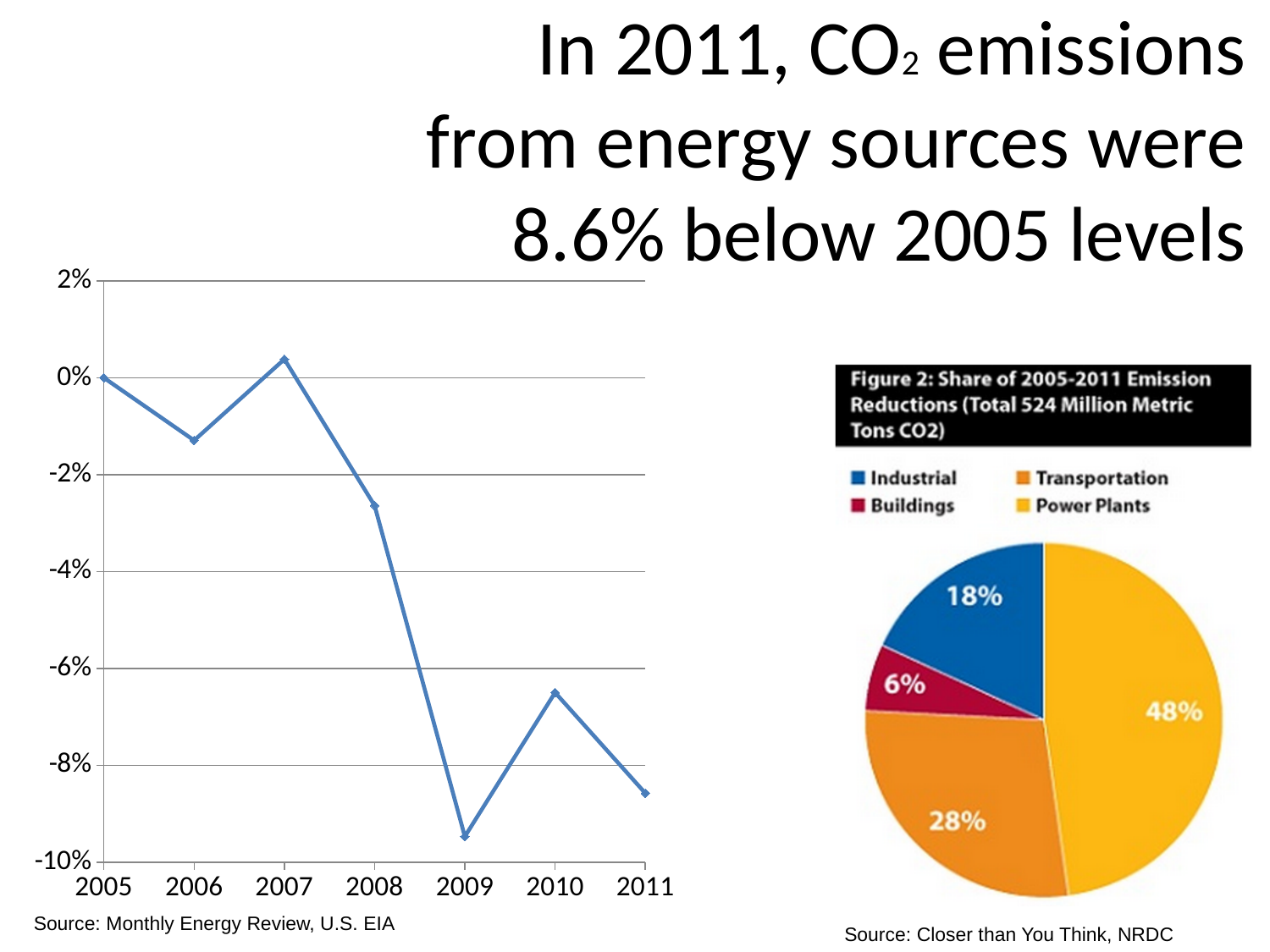
In Figure 2, which category has the largest share of emission reductions? Power Plants In Figure 2, which category has the smallest share of emission reductions? Buildings In the line chart on the left, which year has the lowest value? 2009 In the line chart on the left, is the value for 2008 greater or less than -4%? greater In the line chart on the left, how many years are plotted along the x axis? 7 In the line chart on the left, what is the value for 2005? 0% In the line chart on the left, is the value for 2009 greater or less than -8%? less What kind of chart is the chart on the left of the slide? line chart In the line chart on the left, which year has the higher value, 2010 or 2011? 2010 In Figure 2, what share of emission reductions comes from Transportation? 28% What kind of chart is Figure 2 on the right of the slide? pie chart In Figure 2, how many percentage points larger is the Power Plants share than the Industrial share? 30 percentage points